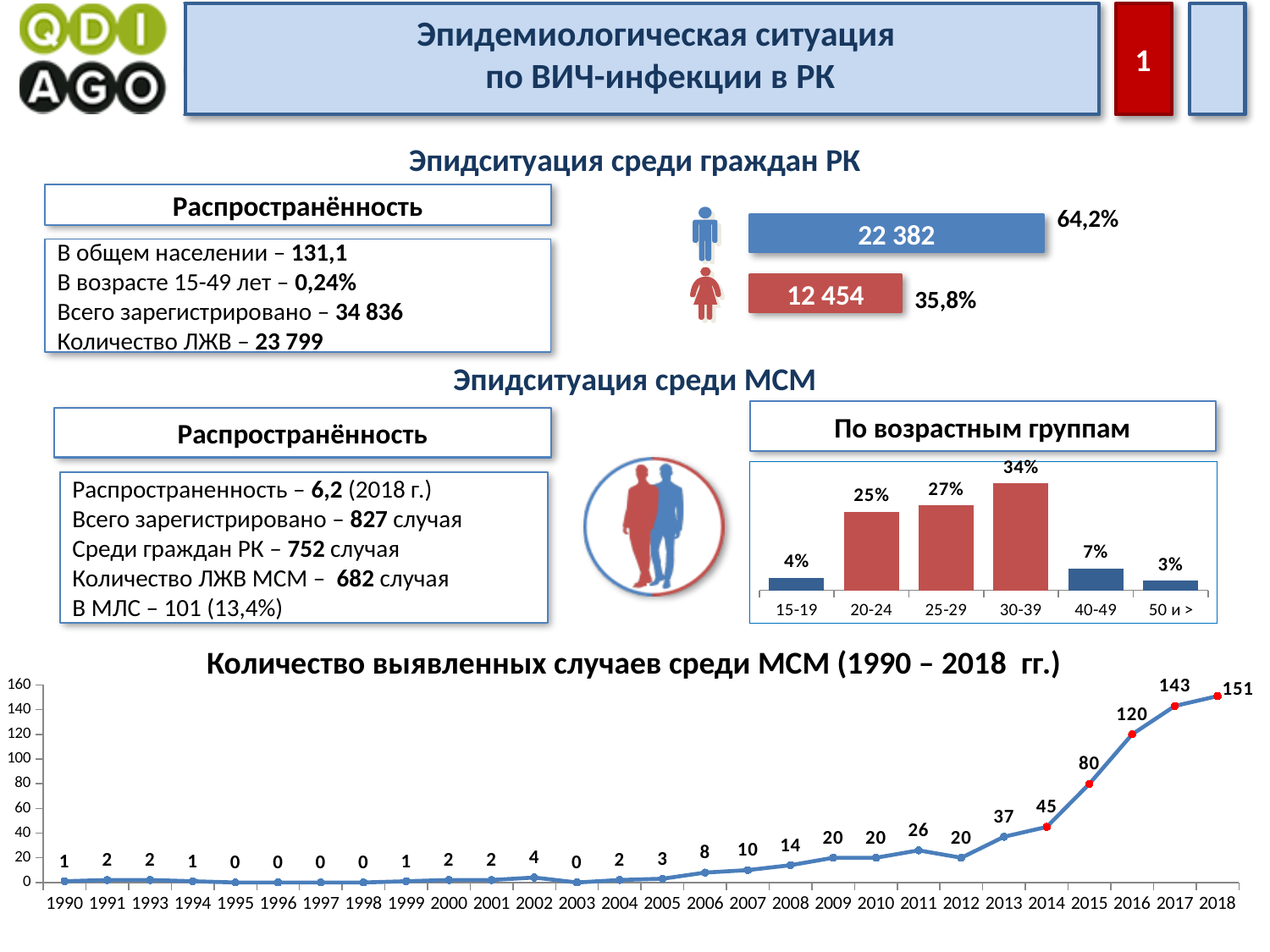
In the chart 'По возрастным группам', which age group has the lowest value? 50 и > In the chart 'Количество выявленных случаев среди МСМ (1990 – 2018 гг.)', what is the value for 2016? 120 In the chart 'Количество выявленных случаев среди МСМ (1990 – 2018 гг.)', do the values rise or fall from 2013 to 2018? rise In the chart 'По возрастным группам', which age group has the highest value? 30-39 In the chart 'Количество выявленных случаев среди МСМ (1990 – 2018 гг.)', which year has the larger value, 2011 or 2012? 2011 In the chart 'Количество выявленных случаев среди МСМ (1990 – 2018 гг.)', what is the difference between the values for 2018 and 2017? 8 In the chart 'По возрастным группам', what is the value for the 30-39 age group? 34% What kind of chart is 'По возрастным группам'? bar chart In the chart 'По возрастным группам', what is the difference between the values for 25-29 and 20-24? 2% How many age groups are shown in the chart 'По возрастным группам'? 6 What kind of chart is 'Количество выявленных случаев среди МСМ (1990 – 2018 гг.)'? line chart In the horizontal bar chart next to the male and female icons in the 'Эпидситуация среди граждан РК' section, what is the value of the blue bar? 22 382